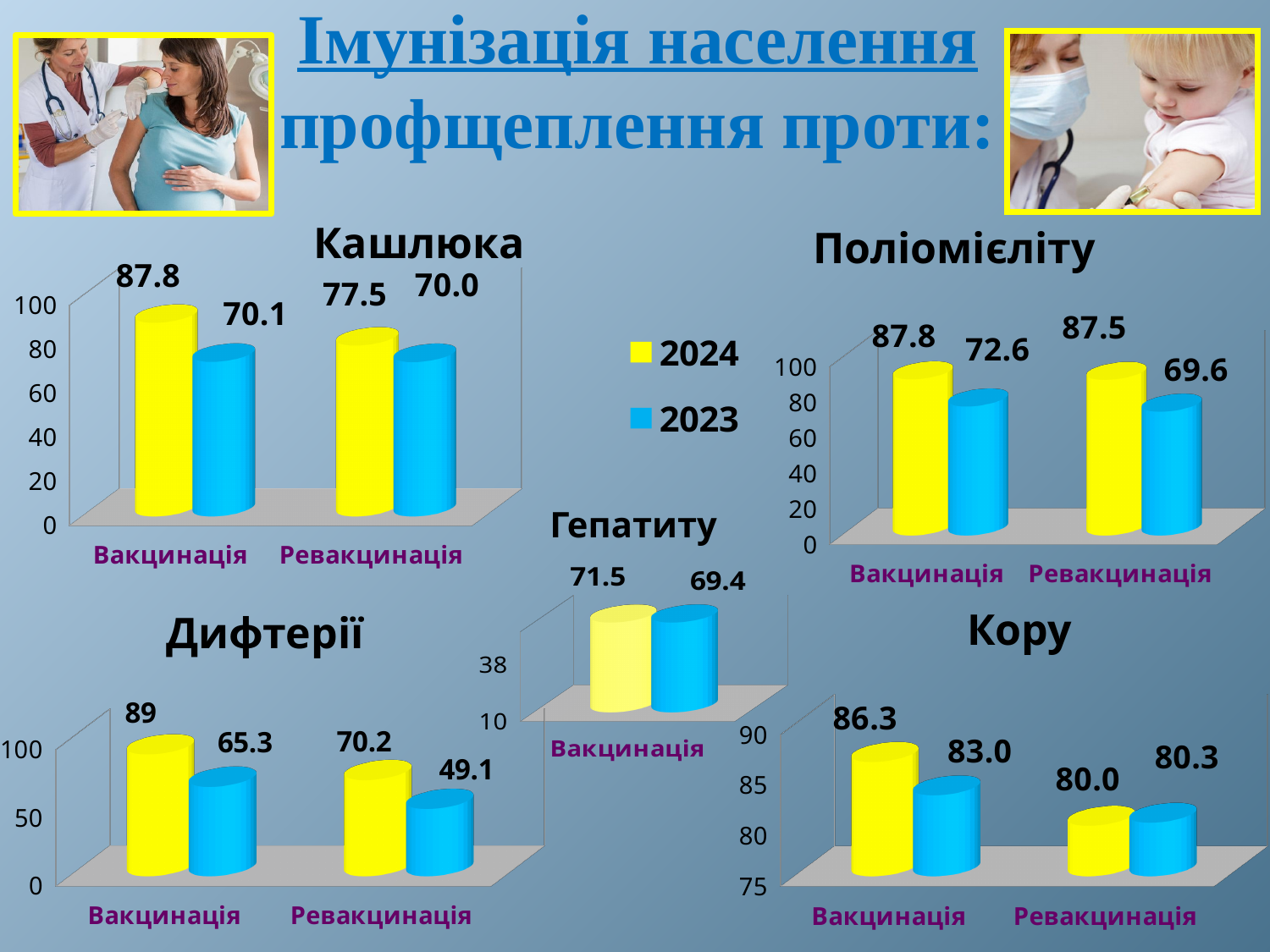
In the Гепатиту chart, what is the 2024 value for Вакцинація? 71.5 In the Поліомієліту chart, what is the difference between the 2024 and 2023 values for Ревакцинація? 17.9 How many series does the legend list? 2 What kind of chart is the Кашлюка chart? Bar chart In the Дифтерії chart, what is the difference between the 2024 and 2023 values for Вакцинація? 23.7 In the Кору chart, what is the 2024 value for Вакцинація? 86.3 Which colour represents 2024 in the legend? Yellow In the Кору chart, which is larger for Ревакцинація: the 2024 value or the 2023 value? 2023 In the Дифтерії chart, which category has the lowest value? Ревакцинація (2023) In the Кашлюка chart, what is the 2024 value for Вакцинація? 87.8 In the Поліомієліту chart, what is the 2023 value for Вакцинація? 72.6 In the Кашлюка chart, what is the 2023 value for Ревакцинація? 70.0